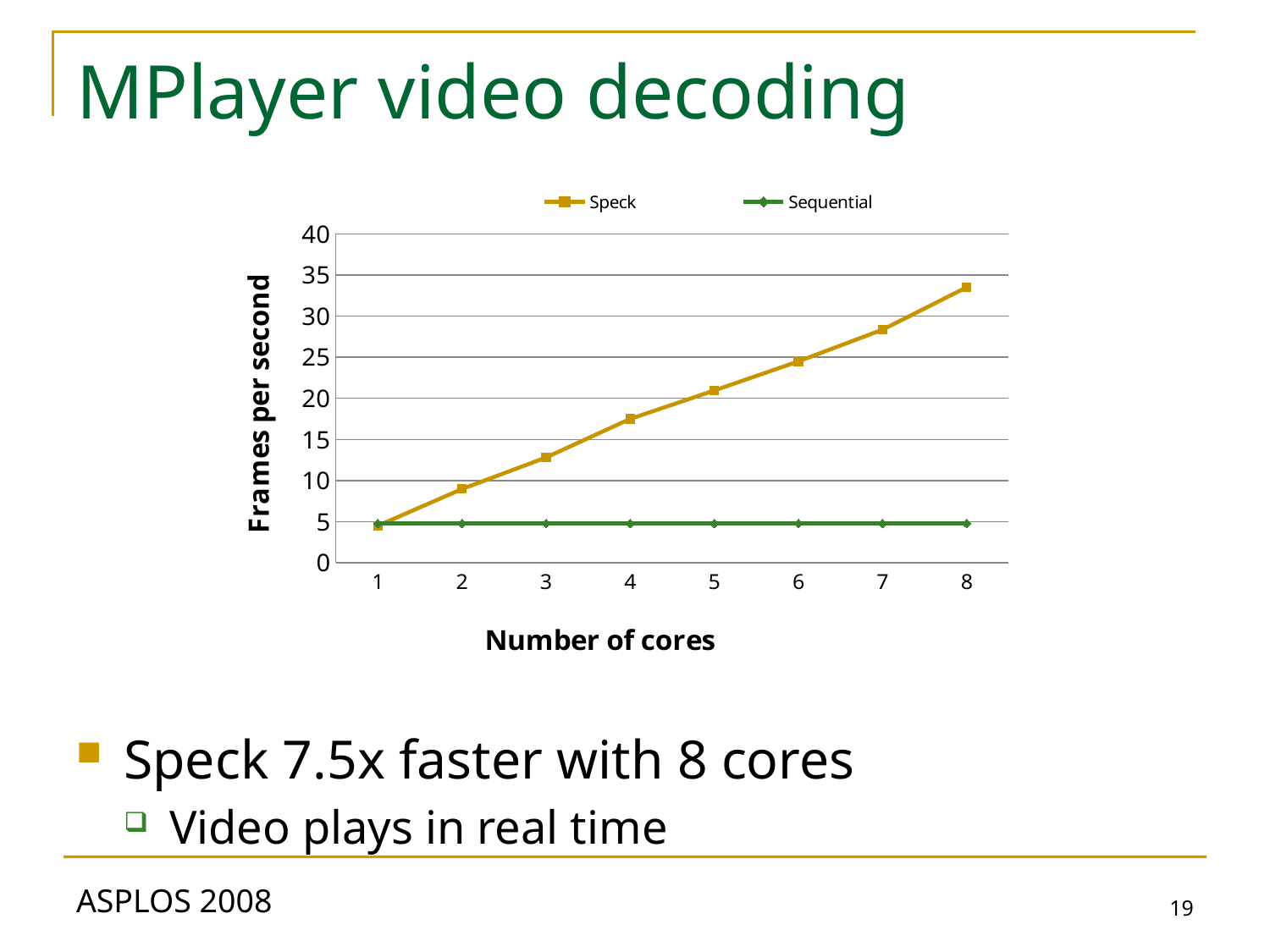
At 8 cores, which series has the higher frames per second, Speck or Sequential? Speck What kind of chart is shown on the slide? line chart Does the Sequential series rise, fall, or stay flat as the number of cores increases? stays flat Does the Speck series rise or fall as the number of cores increases? rises Is the Sequential value at 8 cores greater or less than 10 frames per second? less Is the Speck value at 6 cores greater or less than 20 frames per second? greater Is the Speck value at 8 cores greater or less than 30 frames per second? greater What is the label of the y axis? Frames per second How many core counts are plotted along the x axis? 8 At which number of cores does the Speck series reach its highest frames per second? 8 How many series does the legend list? 2